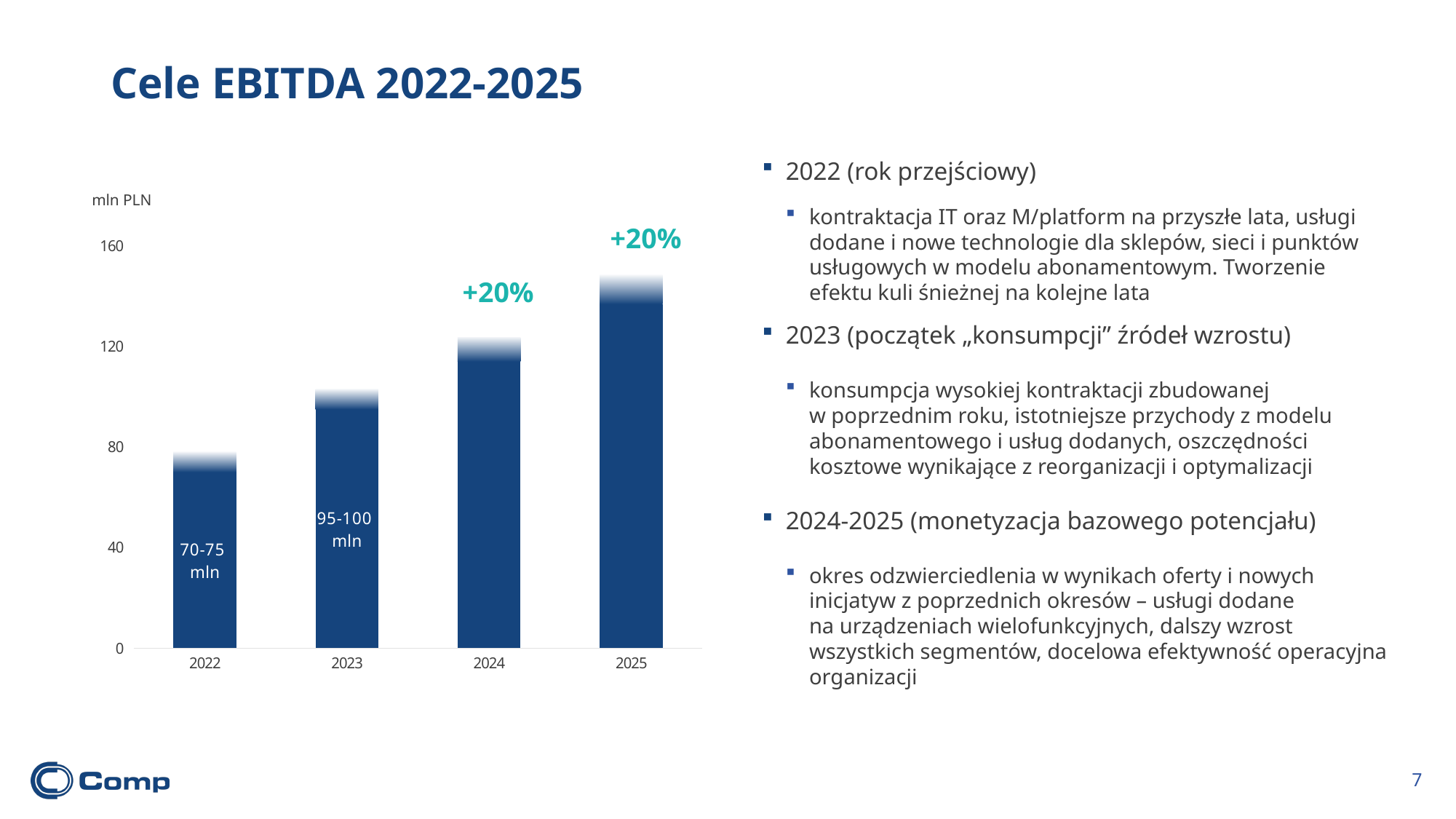
What is the data label on the bar for 2023? 95-100 mln Do the bar values rise or fall from 2022 to 2025? rise What is the data label on the bar for 2022? 70-75 mln What kind of chart is shown on the slide? bar chart What percentage change is shown above the bar for 2025? +20% What unit is shown on the chart's vertical axis? mln PLN Which year has the lowest bar in the chart? 2022 How many years (bars) are shown in the chart? 4 What percentage change is shown above the bar for 2024? +20% Is the value for 2023 greater or less than 80? greater Which year has the highest bar in the chart? 2025 Is the value for 2025 greater or less than 120? greater